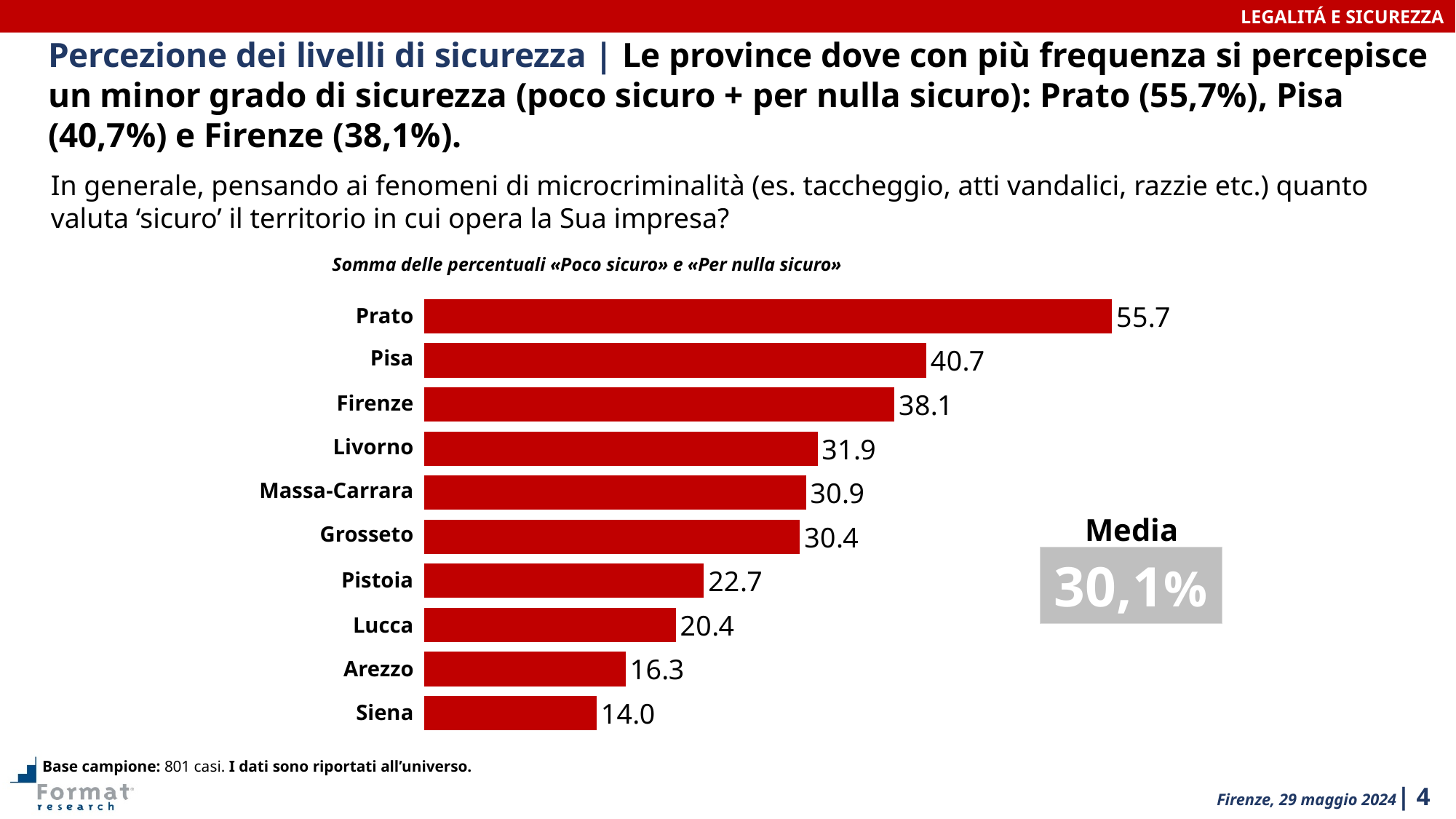
What is the 'Media' value shown next to the chart? 30,1% What is the value for Livorno? 31.9 What is the value for Lucca? 20.4 Which is larger, the value for Firenze or the value for Grosseto? Firenze What is the value for Prato? 55.7 What is the difference between the values for Prato and Pisa? 15.0 How many provinces are shown in the chart? 10 Which province has the highest value? Prato What is the difference between the values for Pistoia and Arezzo? 6.4 Which province has the lowest value? Siena What kind of chart is shown on the slide? Bar chart What colour are the bars in the chart? Red